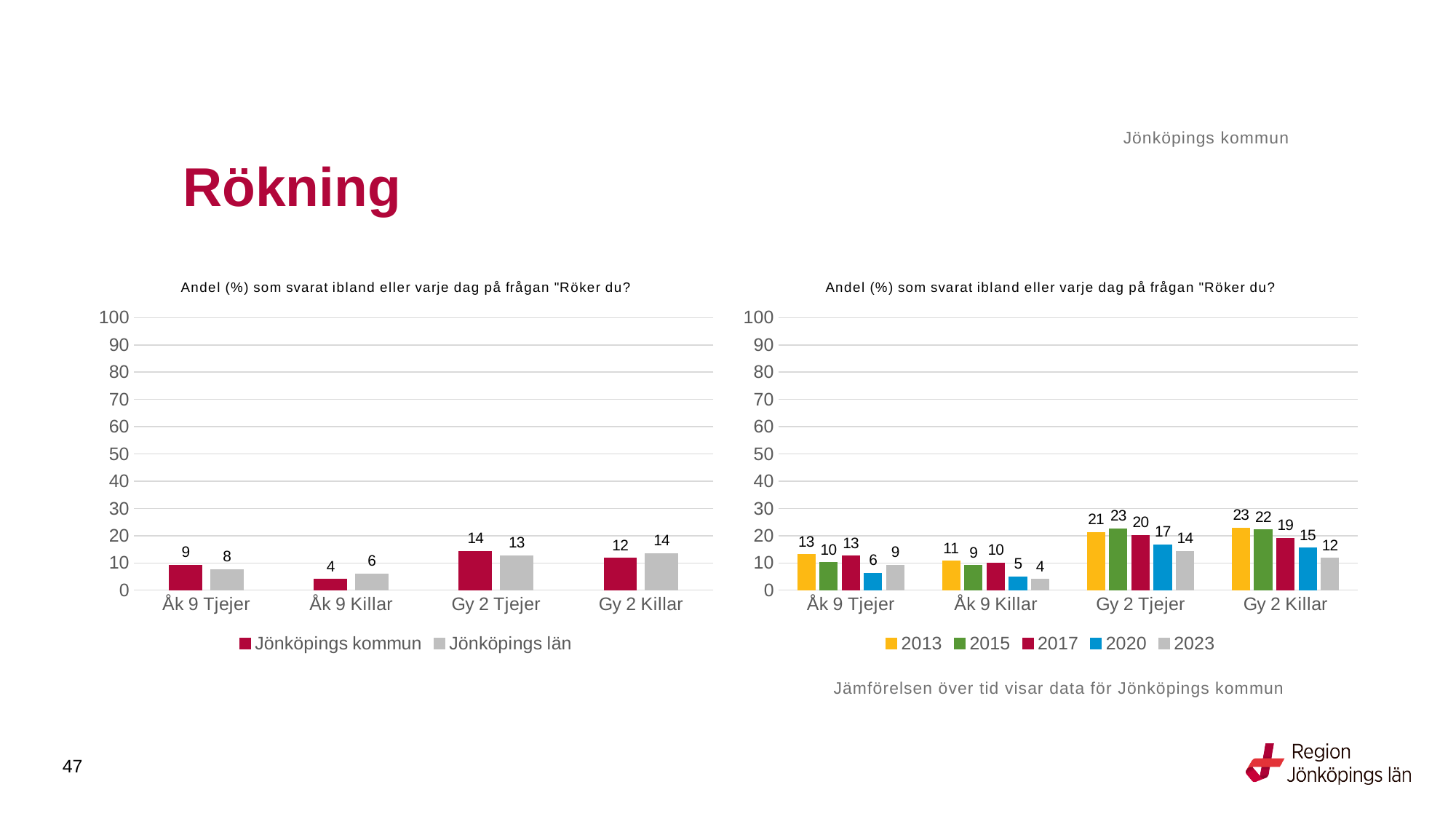
What kind of chart is the right chart? Bar chart In the left chart, how many series does the legend list? 2 In the left chart, which category has the highest value for Jönköpings kommun? Gy 2 Tjejer In the right chart, what is the value for 2020 for Gy 2 Tjejer? 17 In the right chart, what is the value for 2013 for Gy 2 Killar? 23 In the right chart, which category has the lowest value for 2023? Åk 9 Killar In the left chart, what is the difference between Jönköpings kommun and Jönköpings län for Åk 9 Killar? 2 In the right chart, how many series does the legend list? 5 In the left chart, what is the value for Jönköpings kommun for Åk 9 Killar? 4 In the right chart, what is the difference between the 2013 and 2023 values for Gy 2 Killar? 11 In the left chart, what is the value for Jönköpings län for Gy 2 Killar? 14 In the right chart, is the value for 2015 for Gy 2 Tjejer larger or smaller than the value for 2023 for Gy 2 Tjejer? larger